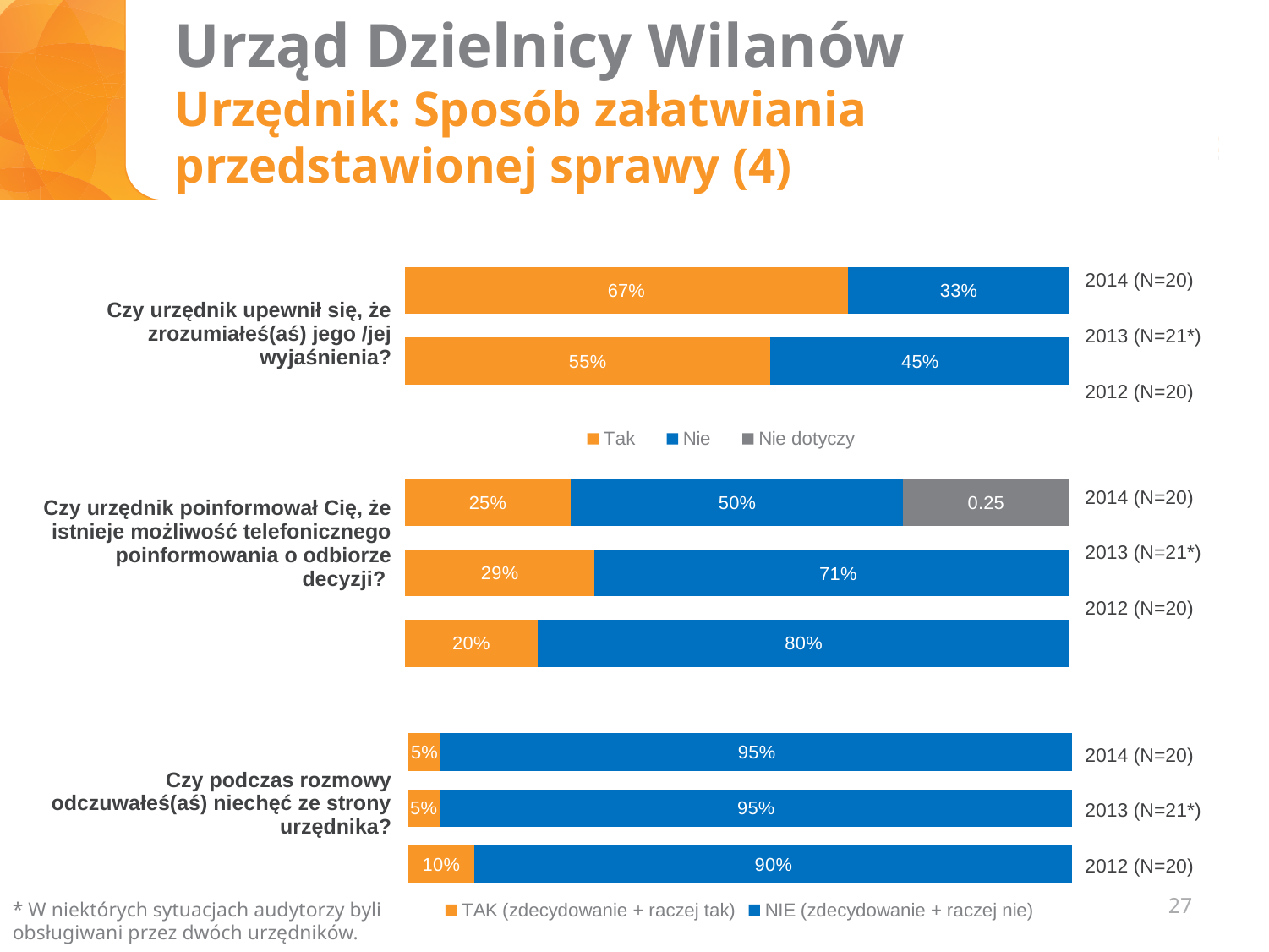
What type of chart is used on this slide? Stacked bar chart In the bottom chart ("Czy podczas rozmowy odczuwałeś(aś) niechęć ze strony urzędnika?"), what is the TAK value for 2012 (N=20)? 10% In the bottom chart ("Czy podczas rozmowy odczuwałeś(aś) niechęć ze strony urzędnika?"), how many years (bars) are shown? 3 In the top chart ("Czy urzędnik upewnił się, że zrozumiałeś(aś) jego /jej wyjaśnienia?"), what is the Tak value for 2014 (N=20)? 67% In the middle chart ("Czy urzędnik poinformował Cię, że istnieje możliwość telefonicznego poinformowania o odbiorze decyzji?"), how many series does the legend list? 3 In the middle chart ("Czy urzędnik poinformował Cię, że istnieje możliwość telefonicznego poinformowania o odbiorze decyzji?"), which year has the highest Tak value? 2013 (N=21*) In the middle chart ("Czy urzędnik poinformował Cię, że istnieje możliwość telefonicznego poinformowania o odbiorze decyzji?"), what value is shown for the Nie dotyczy segment in 2014 (N=20)? 0.25 In the top chart ("Czy urzędnik upewnił się, że zrozumiałeś(aś) jego /jej wyjaśnienia?"), what is the difference between the Tak values for 2014 and 2013? 12 percentage points In the top chart ("Czy urzędnik upewnił się, że zrozumiałeś(aś) jego /jej wyjaśnienia?"), what is the Nie value for 2013 (N=21*)? 45% In the bottom chart ("Czy podczas rozmowy odczuwałeś(aś) niechęć ze strony urzędnika?"), is the NIE value for 2014 larger or smaller than the NIE value for 2012? larger In the middle chart ("Czy urzędnik poinformował Cię, że istnieje możliwość telefonicznego poinformowania o odbiorze decyzji?"), what is the Nie value for 2012 (N=20)? 80% In the middle chart ("Czy urzędnik poinformował Cię, że istnieje możliwość telefonicznego poinformowania o odbiorze decyzji?"), which year has the lowest Tak value? 2012 (N=20)